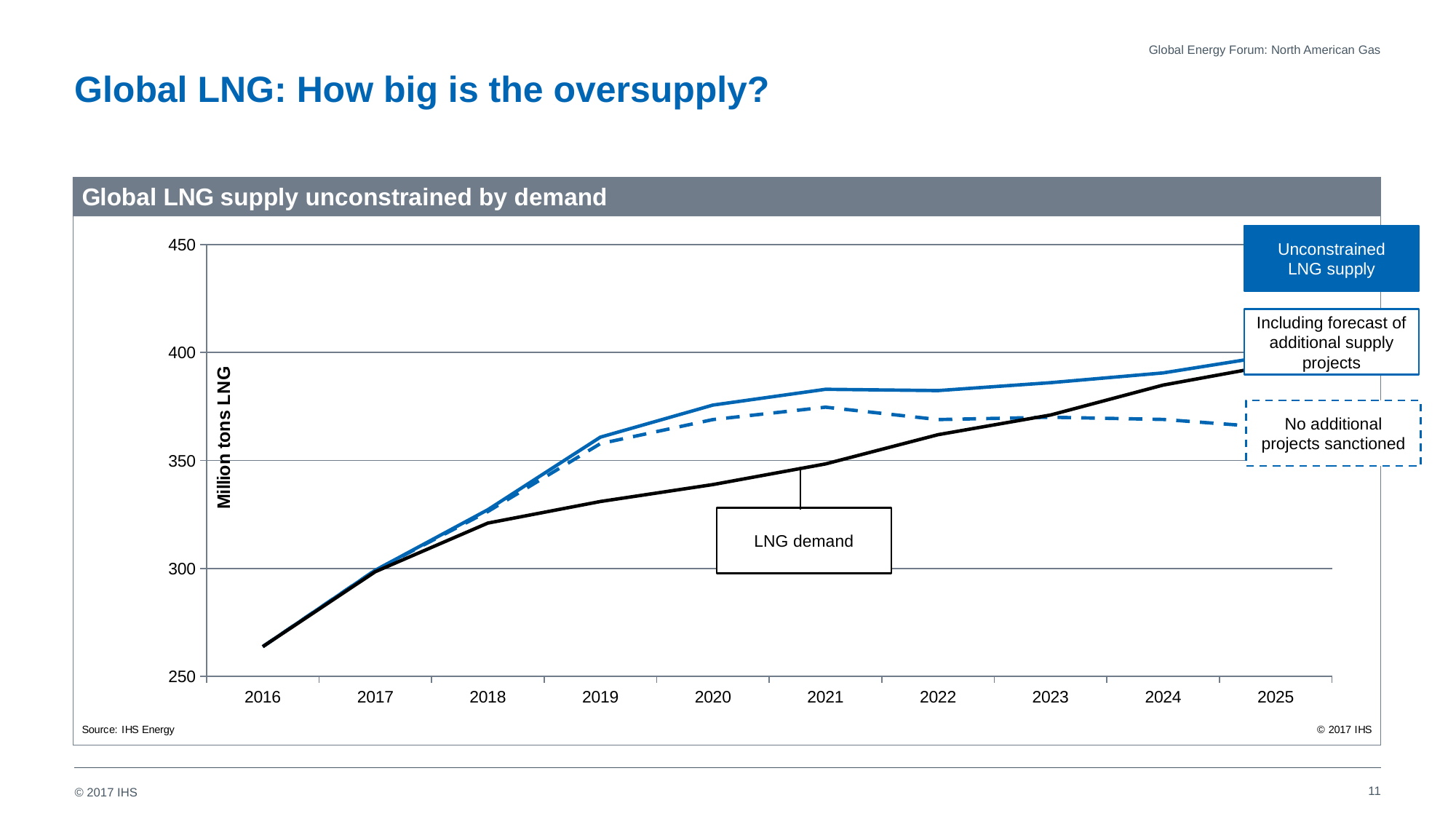
In 2021, which is higher: the 'Including forecast of additional supply projects' line or the LNG demand line? Including forecast of additional supply projects How many lines (series) are plotted on the chart? 3 In 2025, which is higher: the LNG demand line or the 'No additional projects sanctioned' line? LNG demand What is the title of the chart? Global LNG supply unconstrained by demand What is the label on the y axis of the chart? Million tons LNG Does the 'No additional projects sanctioned' line rise or fall from 2021 to 2025? Falls Is the value for LNG demand in 2019 greater or less than 350? less Is the value for the 'Including forecast of additional supply projects' line in 2021 greater or less than 350? greater How many years are shown on the x axis of the chart? 10 Is the value for LNG demand in 2016 greater or less than 300? less Does the LNG demand line rise or fall from 2016 to 2025? Rises What kind of chart is shown on the slide? Line chart